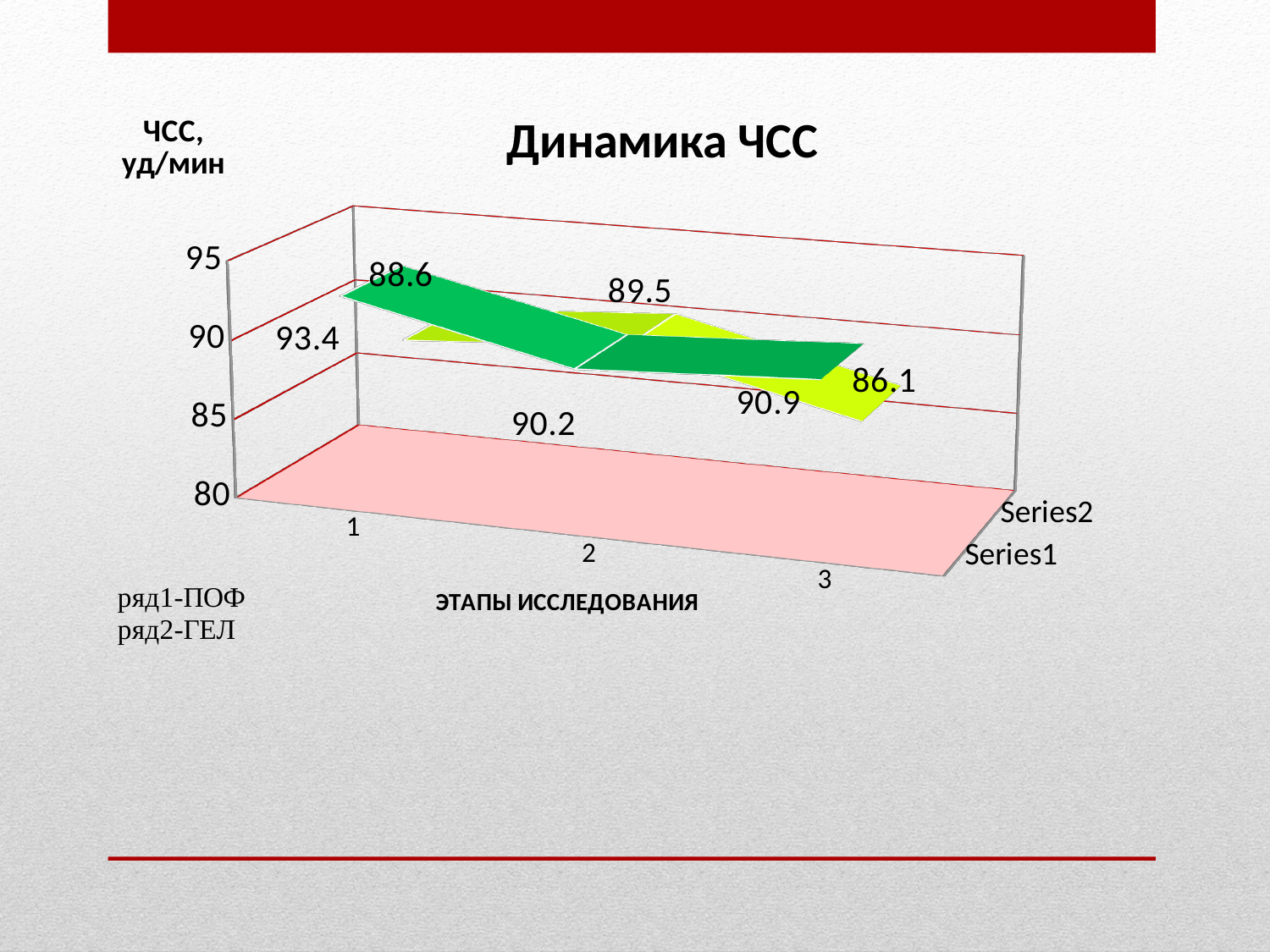
What is the value of Series2 at stage 3? 86.1 What is the difference between the Series1 values at stage 1 and stage 2? 3.2 How many series does the chart legend list? 2 How many stages (categories) are shown on the x axis? 3 At which stage does Series2 have its lowest value? 3 At which stage does Series1 reach its highest value? 1 What is the title of the chart? Динамика ЧСС What type of chart is shown on the slide? line chart At stage 3, which series has the larger value, Series1 or Series2? Series1 What is the label of the vertical axis? ЧСС, уд/мин What is the difference between the Series2 values at stage 2 and stage 3? 3.4 What is the value of Series1 at stage 1? 93.4